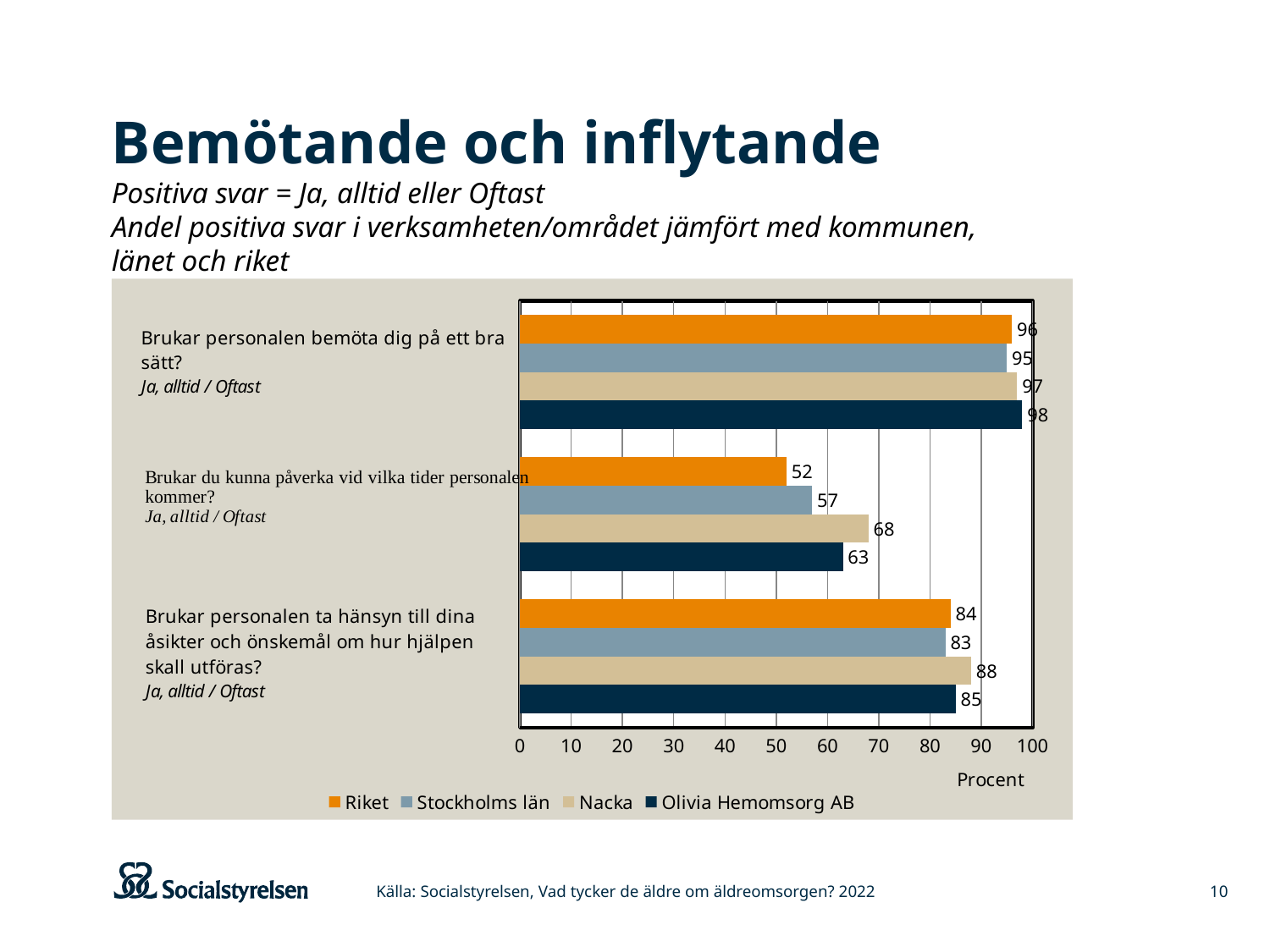
What kind of chart is shown on the slide? Bar chart What is the difference between Nacka and Riket for the question "Brukar du kunna påverka vid vilka tider personalen kommer?"? 16 Which series has the highest value for the question "Brukar du kunna påverka vid vilka tider personalen kommer?"? Nacka How many question categories are plotted on the chart? 3 Which series has the lowest value for the question "Brukar personalen ta hänsyn till dina åsikter och önskemål om hur hjälpen skall utföras?"? Stockholms län What is the value for Nacka for the question "Brukar personalen ta hänsyn till dina åsikter och önskemål om hur hjälpen skall utföras?"? 88 For the question "Brukar personalen ta hänsyn till dina åsikter och önskemål om hur hjälpen skall utföras?", which is larger: Olivia Hemomsorg AB or Riket? Olivia Hemomsorg AB How many series does the legend list? 4 What is the value for Riket for the question "Brukar du kunna påverka vid vilka tider personalen kommer?"? 52 What is the value for Olivia Hemomsorg AB for the question "Brukar personalen bemöta dig på ett bra sätt?"? 98 Is the value for Stockholms län for the question "Brukar du kunna påverka vid vilka tider personalen kommer?" greater or less than 60? less What is the label of the x axis? Procent